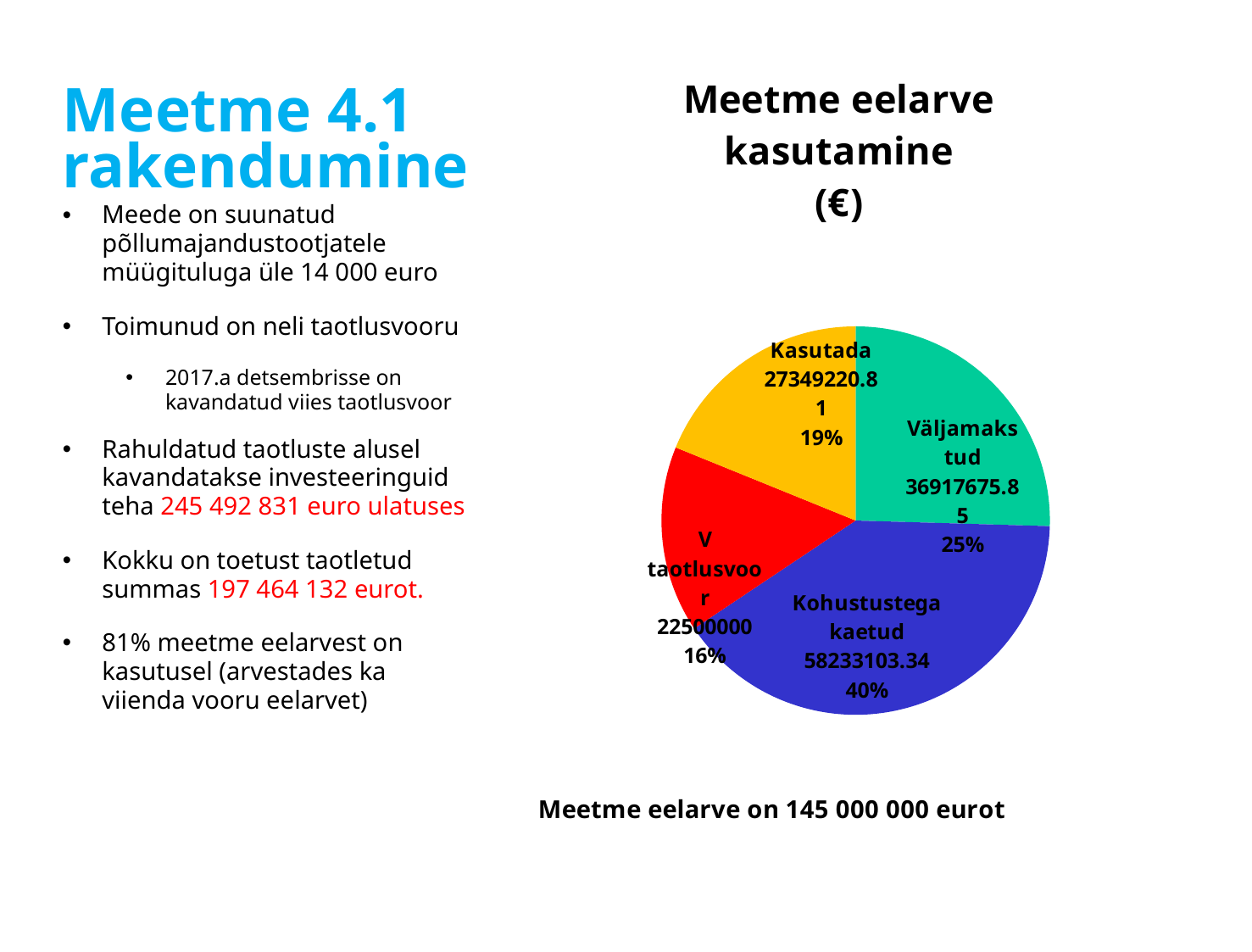
Which slice is the largest? Kohustustega kaetud Which is larger, the Kasutada slice or the Väljamakstud slice? Väljamakstud What share of the pie does the Väljamakstud slice represent? 25% How many slices does the pie chart have? 4 What is the value shown for the V taotlusvoor slice? 22500000 What kind of chart is shown on the slide? pie chart What is the title of the chart? Meetme eelarve kasutamine (€) What is the value shown for the Kasutada slice? 27349220.81 What share of the pie does the Kasutada slice represent? 19% What is the value shown for the Kohustustega kaetud slice? 58233103.34 Which slice is the smallest? V taotlusvoor What is the value shown for the Väljamakstud slice? 36917675.85